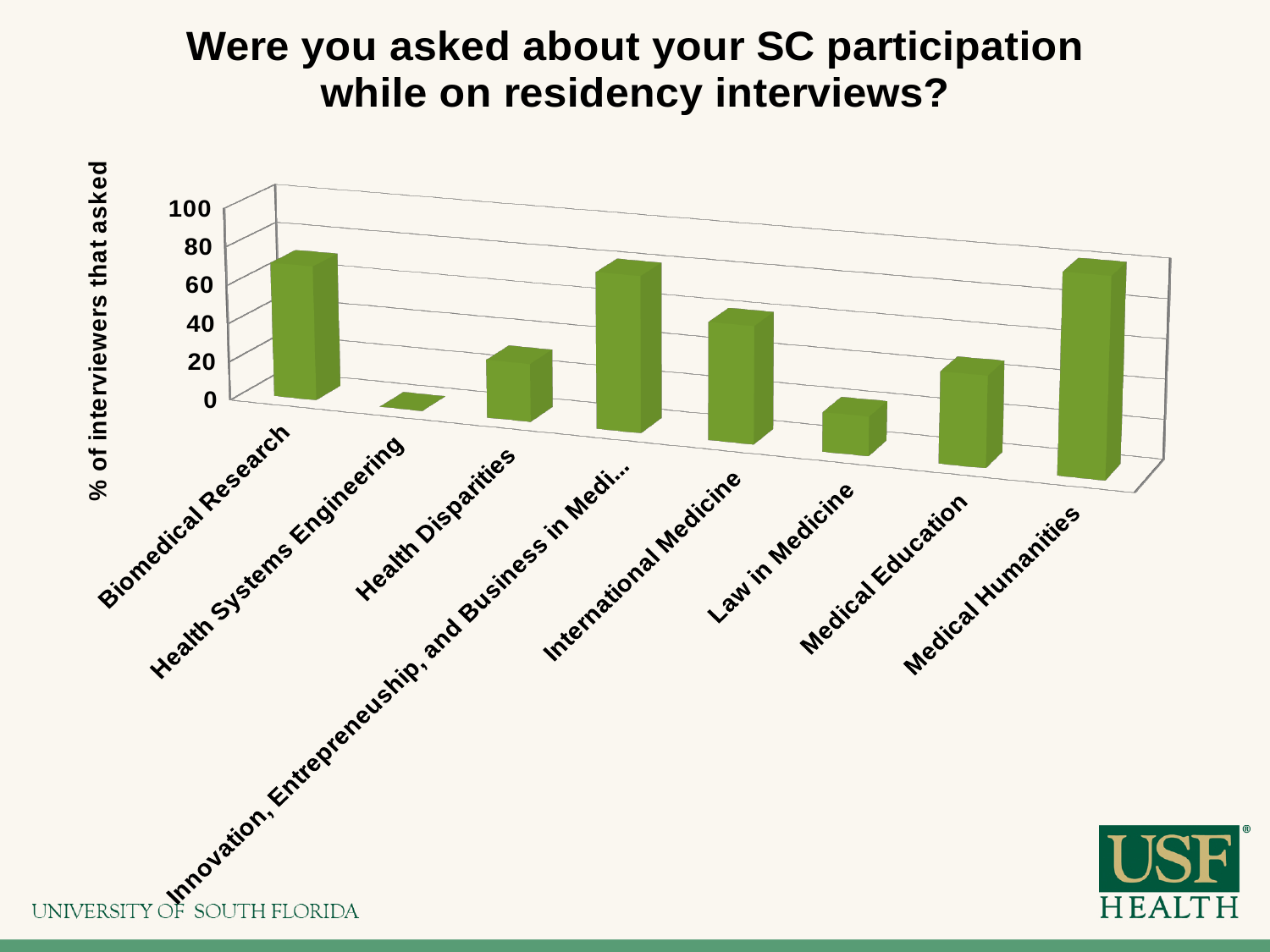
What is the label on the vertical axis of the chart? % of interviewers that asked Which category has the lowest value in the chart? Health Systems Engineering Is the value for Health Systems Engineering greater or less than 20? less Is the value for Medical Humanities greater or less than 40? greater Is the value for International Medicine greater or less than 20? greater Which is larger, the value for Biomedical Research or the value for Law in Medicine? Biomedical Research What kind of chart is shown on the slide? bar chart What is the title of the chart? Were you asked about your SC participation while on residency interviews? Which is larger, the value for Medical Humanities or the value for Medical Education? Medical Humanities How many categories (scholarly concentrations) are shown on the x axis of the chart? 8